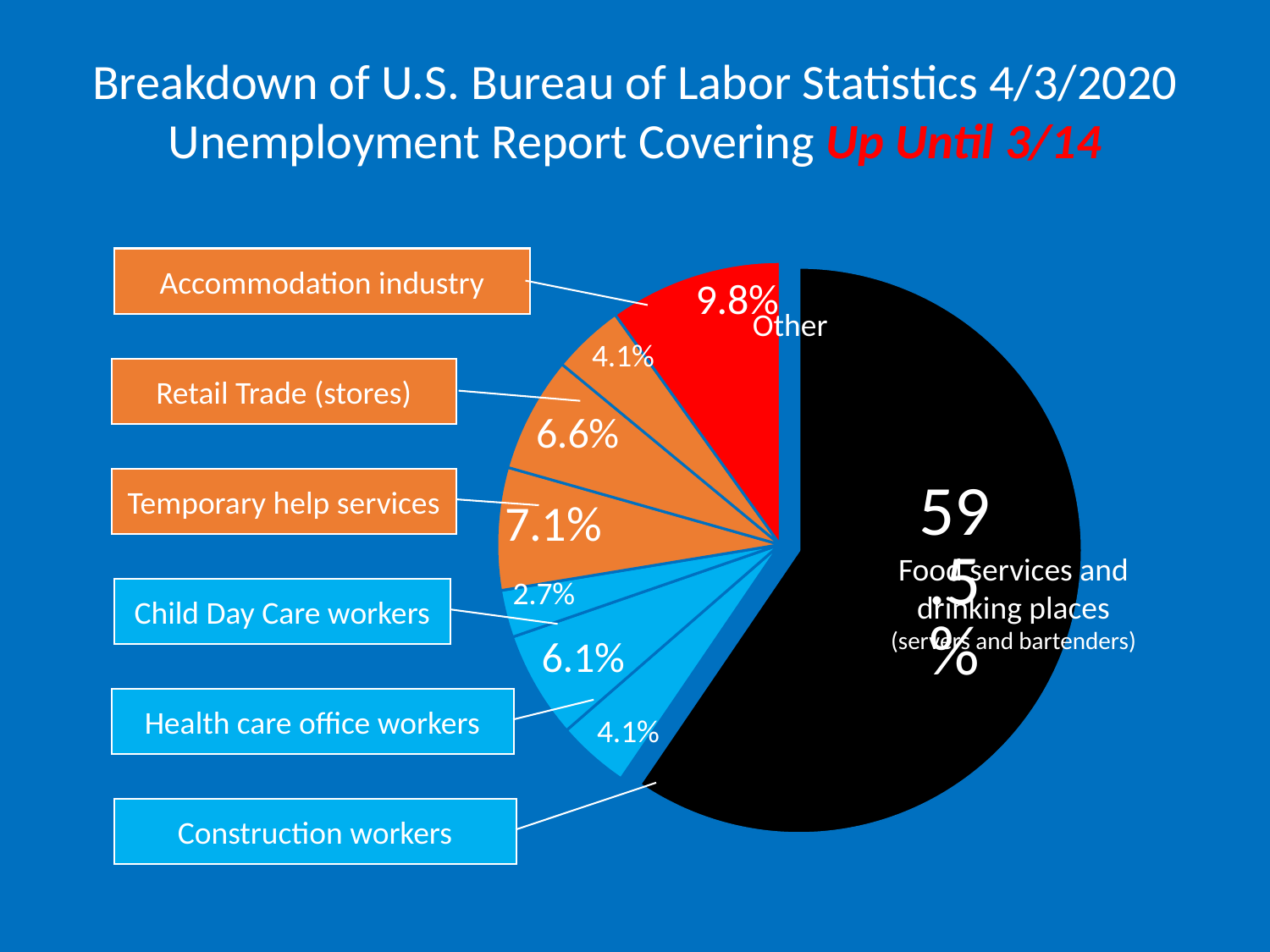
What kind of chart is shown on the slide? pie chart Which is larger, the share for Health care office workers or the share for Retail Trade (stores)? Retail Trade (stores) How much larger is the Temporary help services share than the Retail Trade (stores) share? 0.5% Which labeled category has the smallest slice of the pie? Child Day Care workers What percentage is shown for Temporary help services? 7.1% What percentage is shown for Retail Trade (stores)? 6.6% What percentage is shown for Child Day Care workers? 2.7% What percentage is shown for Health care office workers? 6.1% What percentage is shown for Food services and drinking places? 59.5% What percentage does the Other slice represent? 9.8% How many slices does the pie chart have? 8 Which category has the largest slice of the pie? Food services and drinking places